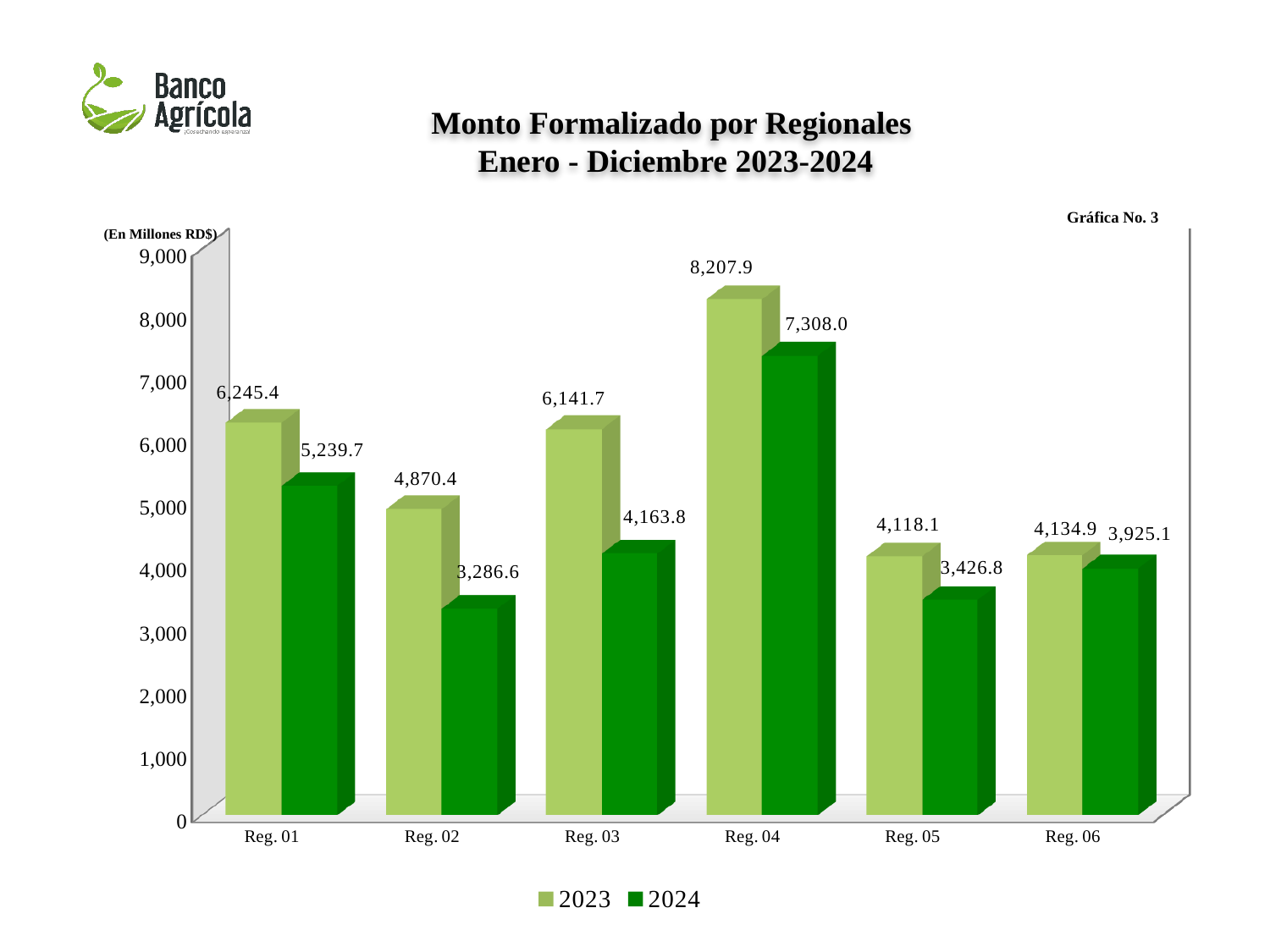
What kind of chart is shown on the slide? bar chart Which is larger, the 2024 value for Reg. 01 or the 2024 value for Reg. 03? Reg. 01 What is the 2023 value for Reg. 04? 8,207.9 What is the 2024 value for Reg. 02? 3,286.6 How many series does the legend list? 2 What is the difference between the 2023 and 2024 values for Reg. 02? 1,583.8 Which region has the lowest 2024 value? Reg. 02 What is the difference between the 2023 and 2024 values for Reg. 04? 899.9 What is the 2024 value for Reg. 06? 3,925.1 Which region has the highest 2023 value? Reg. 04 Is the 2023 value for Reg. 03 greater or less than 6,000? greater How many regions are shown on the x axis? 6